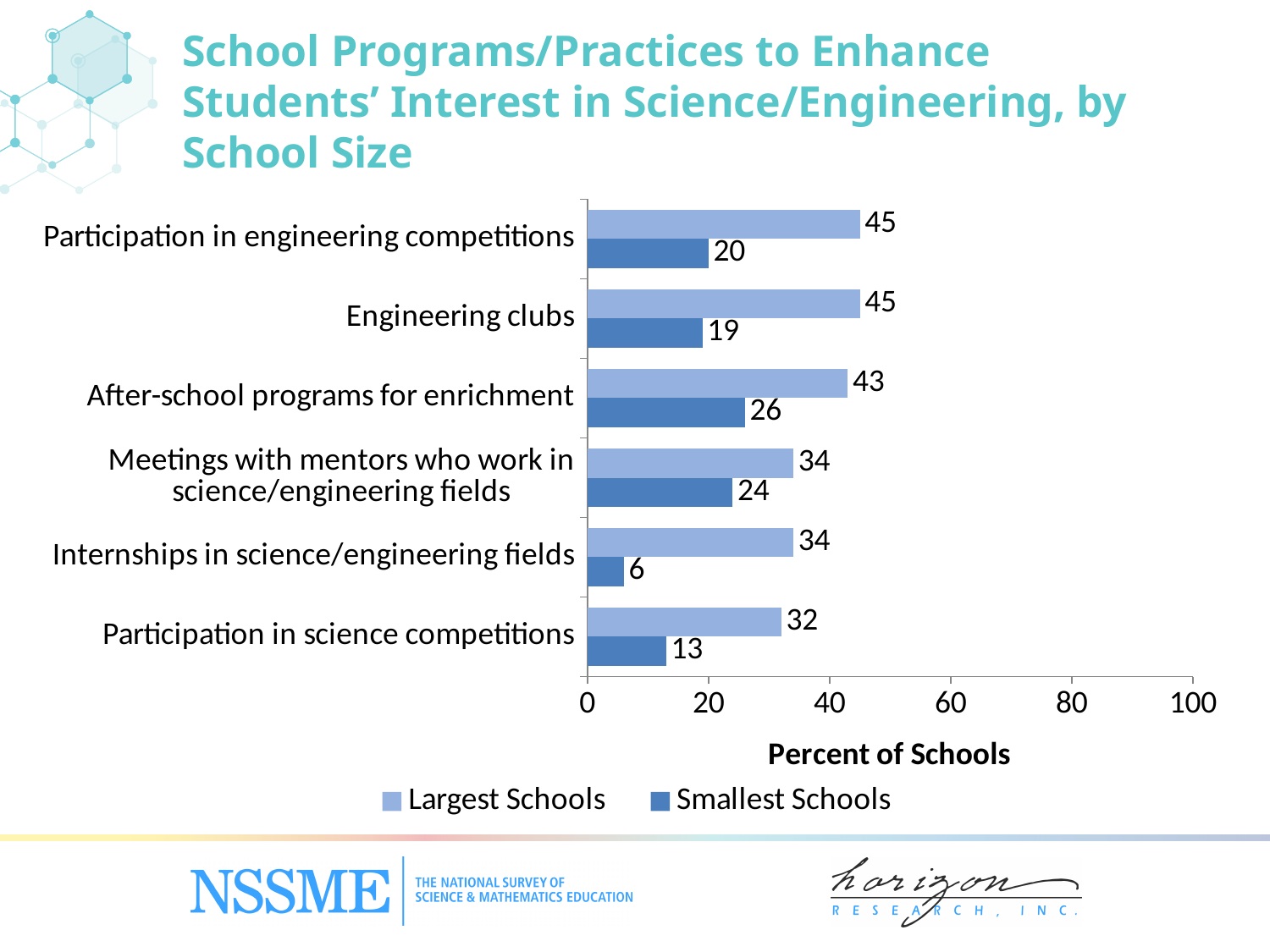
How many categories are shown on the chart? 6 What is the difference between Largest Schools and Smallest Schools for internships in science/engineering fields? 28 How many series does the legend list? 2 For engineering clubs, which is larger: the value for Largest Schools or Smallest Schools? Largest Schools What is the value for Smallest Schools for meetings with mentors who work in science/engineering fields? 24 Which category has the highest value for Smallest Schools? After-school programs for enrichment What percent of the smallest schools offer internships in science/engineering fields? 6 Which category has the lowest value for Smallest Schools? Internships in science/engineering fields What percent of the largest schools offer after-school programs for enrichment? 43 Which category has the lowest value for Largest Schools? Participation in science competitions What kind of chart is shown on the slide? Bar chart What is the difference between Largest Schools and Smallest Schools for participation in engineering competitions? 25